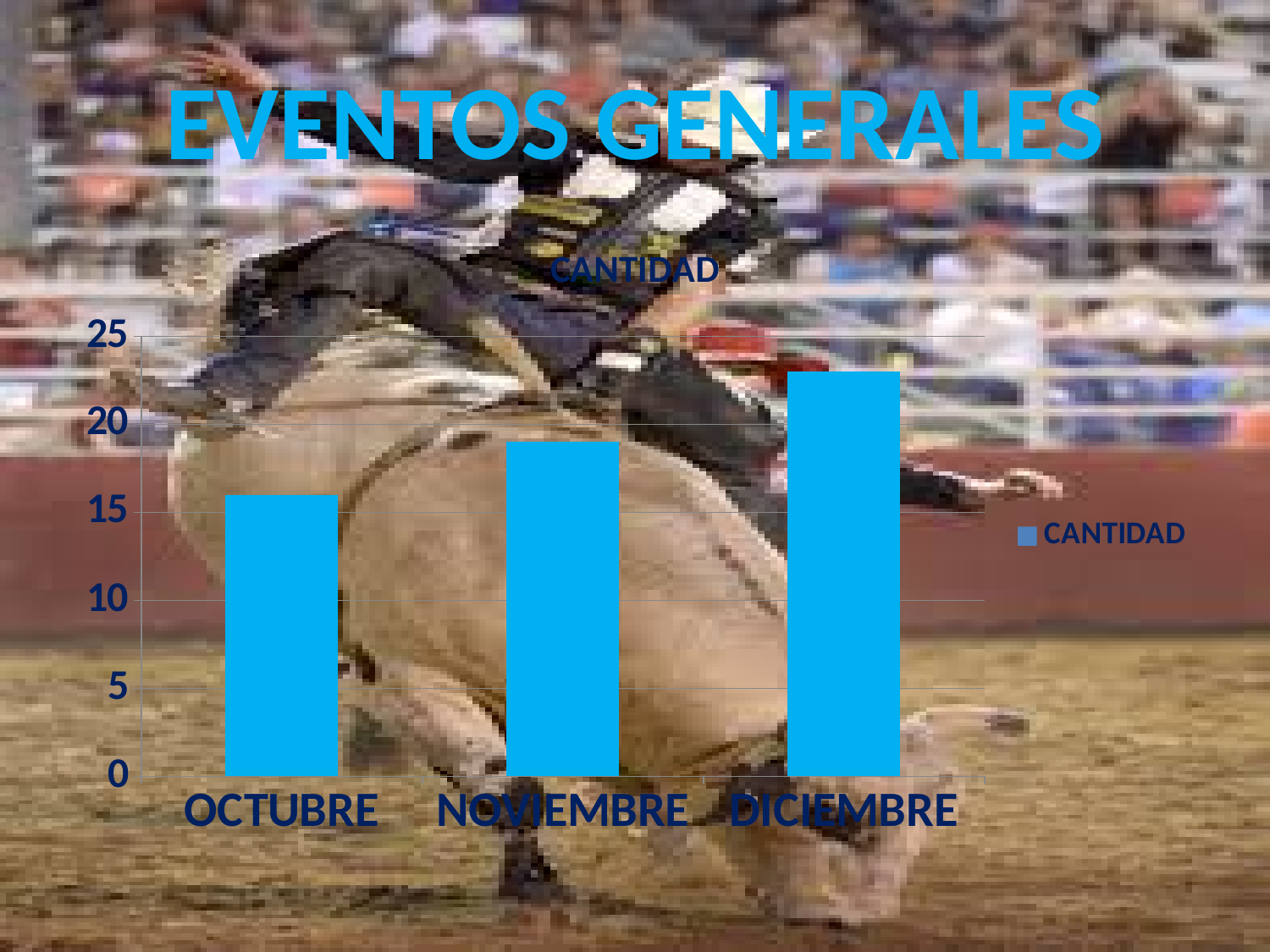
What is the title of the chart? CANTIDAD How many categories are shown on the x axis of the chart? 3 How many series does the chart legend list? 1 Is the value for NOVIEMBRE greater or less than 15? greater What kind of chart is shown on the slide? bar chart Which is larger, the value for NOVIEMBRE or the value for OCTUBRE? NOVIEMBRE Which month has the highest value in the chart? DICIEMBRE Do the values rise or fall from OCTUBRE to DICIEMBRE? rise Which month has the lowest value in the chart? OCTUBRE What is the name of the series shown in the legend? CANTIDAD Is the value for DICIEMBRE greater or less than 20? greater Is the value for OCTUBRE greater or less than 20? less